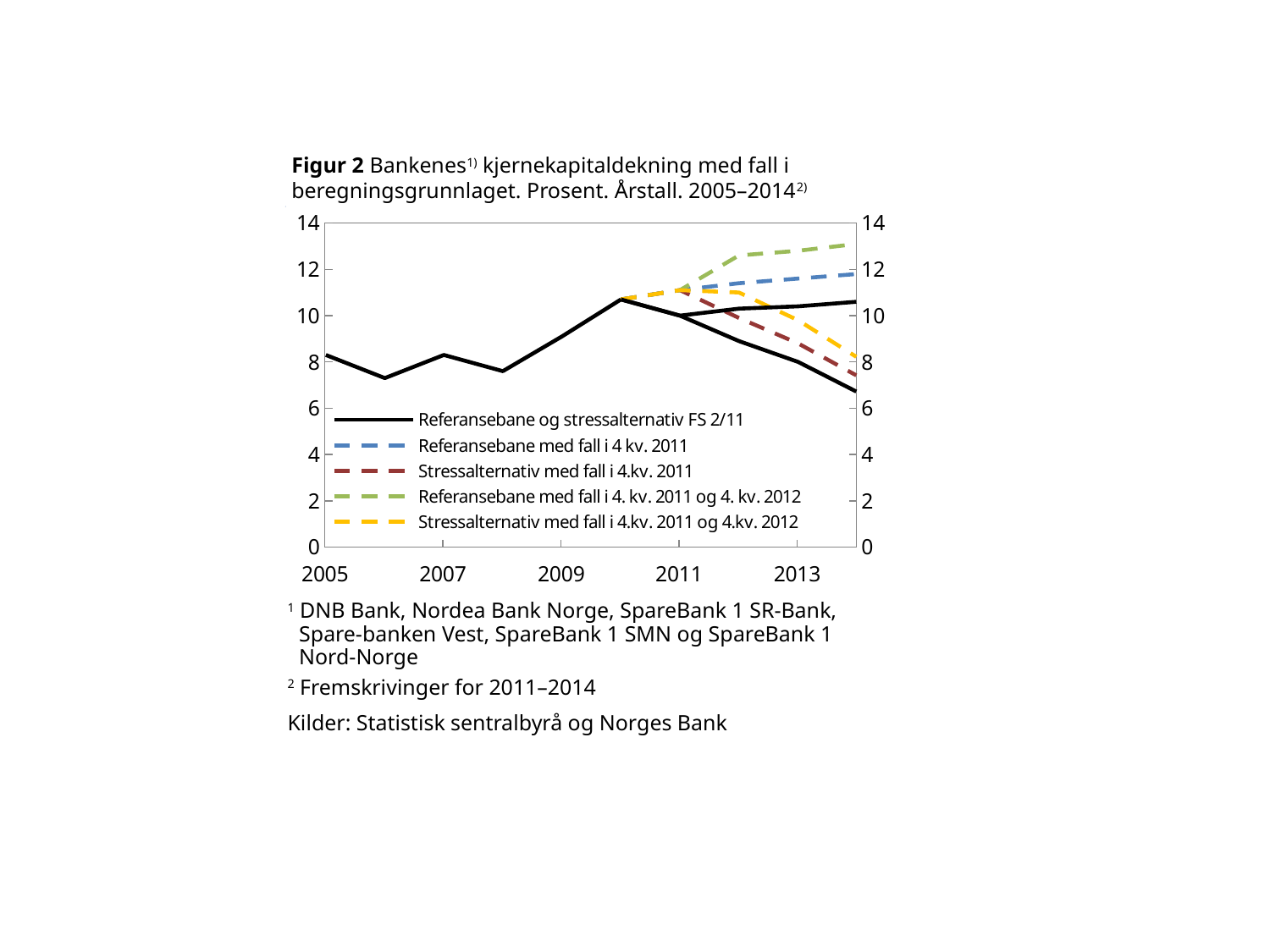
Which series is highest in 2014? Referansebane med fall i 4. kv. 2011 og 4. kv. 2012 Is the value for 'Referansebane med fall i 4. kv. 2011 og 4. kv. 2012' in 2014 greater or less than 12? greater In 2014, which is higher: 'Referansebane med fall i 4 kv. 2011' or 'Stressalternativ med fall i 4.kv. 2011 og 4.kv. 2012'? Referansebane med fall i 4 kv. 2011 What kind of chart is shown on the slide? line chart Does the 'Stressalternativ med fall i 4.kv. 2011' line rise or fall from 2011 to 2014? fall Is the value of the black solid line in 2006 greater or less than 8? less What is the figure number of the chart? Figur 2 How many series does the legend list? 5 Does the 'Referansebane med fall i 4. kv. 2011 og 4. kv. 2012' line rise or fall from 2011 to 2014? rise Is the value for 'Referansebane med fall i 4 kv. 2011' in 2014 greater or less than 10? greater Which series is lowest in 2014? Referansebane og stressalternativ FS 2/11